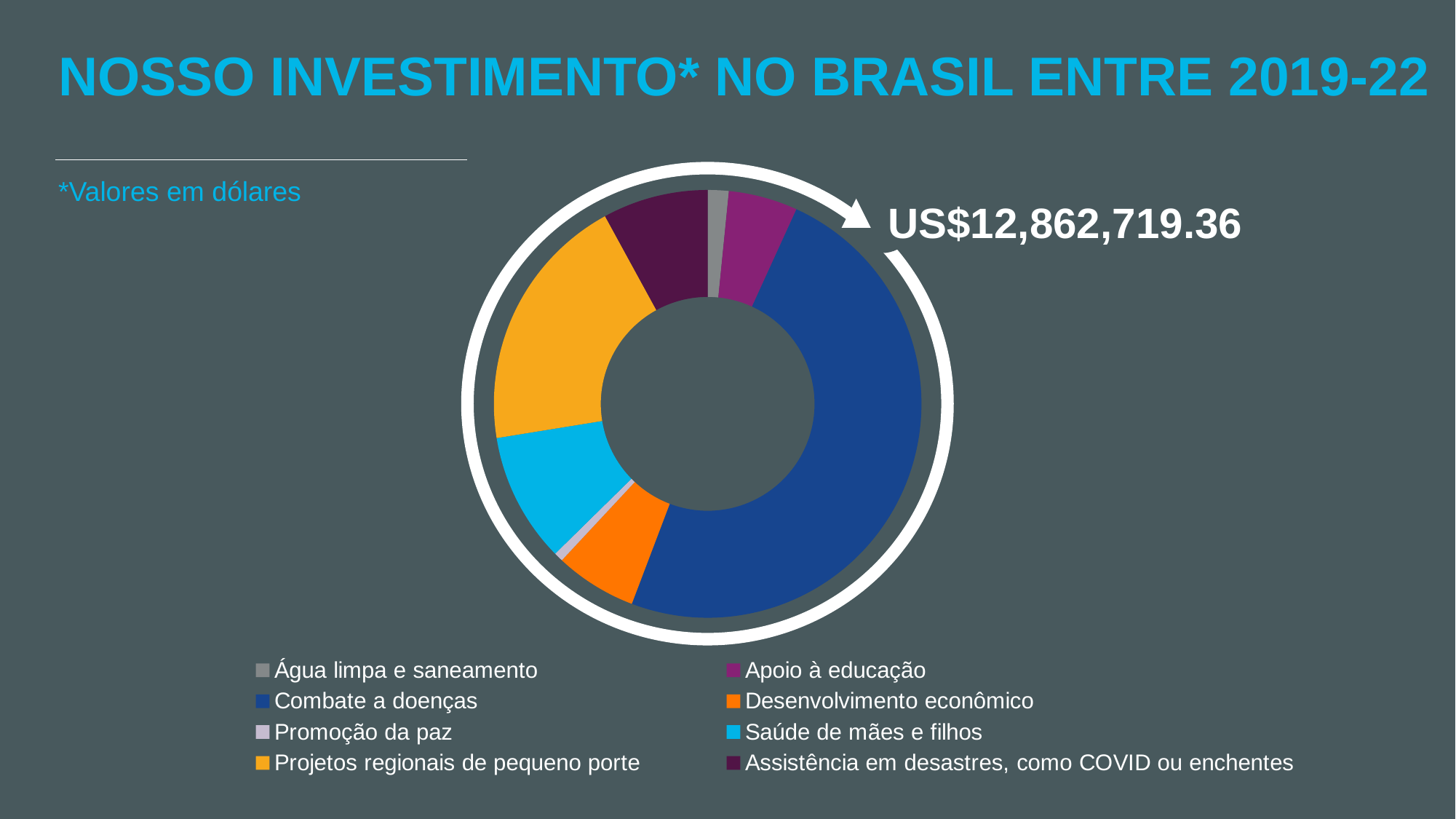
What kind of chart is shown on the slide? donut chart How many categories does the legend of the chart list? 8 Which slice is larger: Assistência em desastres, como COVID ou enchentes or Apoio à educação? Assistência em desastres, como COVID ou enchentes Which category has the largest slice of the chart? Combate a doenças What is the title of the slide containing the chart? NOSSO INVESTIMENTO* NO BRASIL ENTRE 2019-22 What total investment value is printed next to the chart? US$12,862,719.36 Which slice is larger: Saúde de mães e filhos or Água limpa e saneamento? Saúde de mães e filhos Which slice is larger: Combate a doenças or Desenvolvimento econômico? Combate a doenças